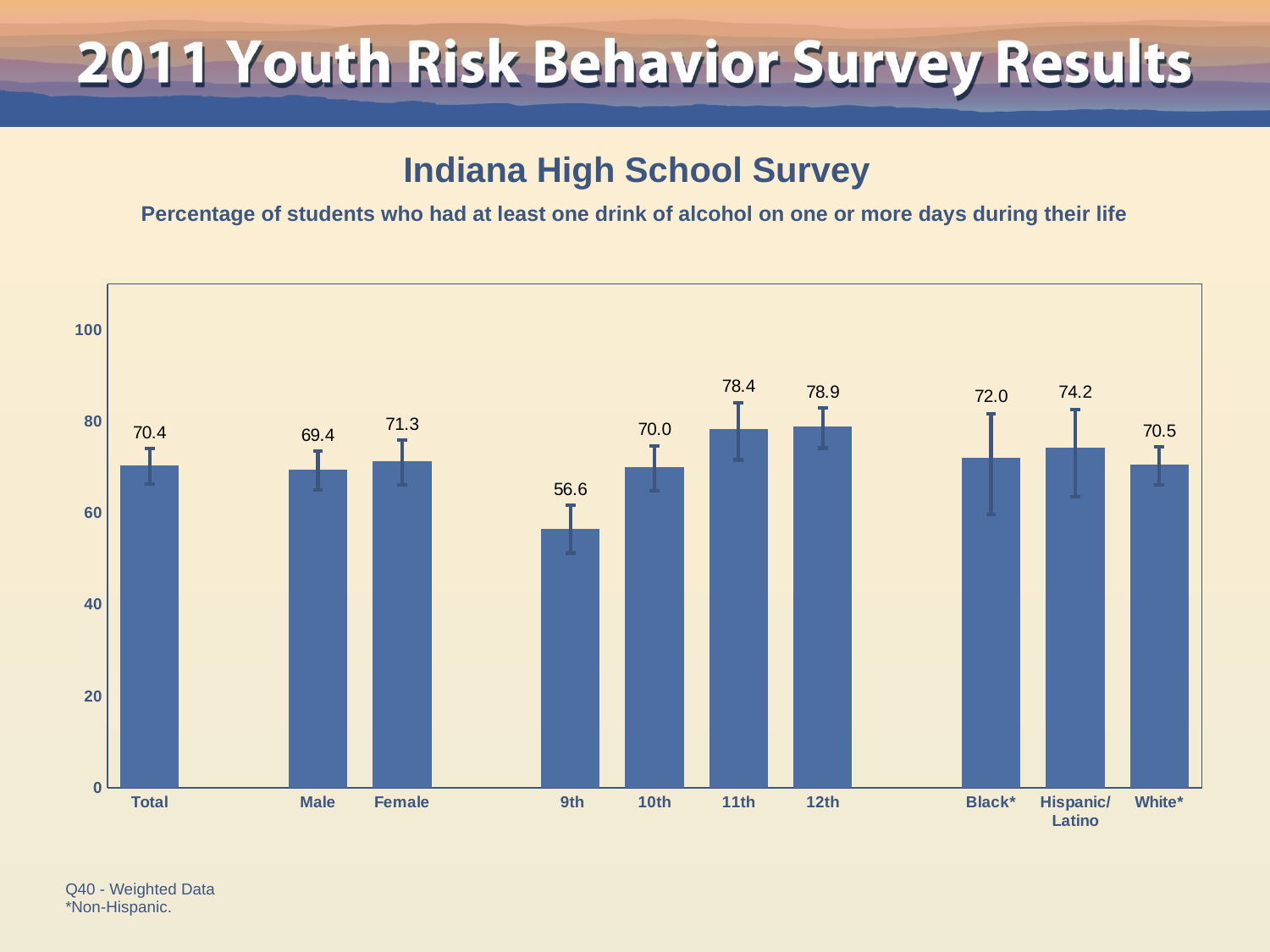
What is the value for Hispanic/Latino students? 74.2 What is the value for 9th grade students? 56.6 Which category has the lowest value? 9th How many categories are shown on the x axis? 10 What is the difference between the values for 12th and 9th grade? 22.3 What is the value for Total? 70.4 What kind of chart is this? bar chart Is the value for 11th grade greater or less than 60? greater Do the values rise or fall from 9th grade to 12th grade? rise Which is larger, the value for Black* or the value for White*? Black* What is the difference between the values for Female and Male? 1.9 Which category has the highest value? 12th